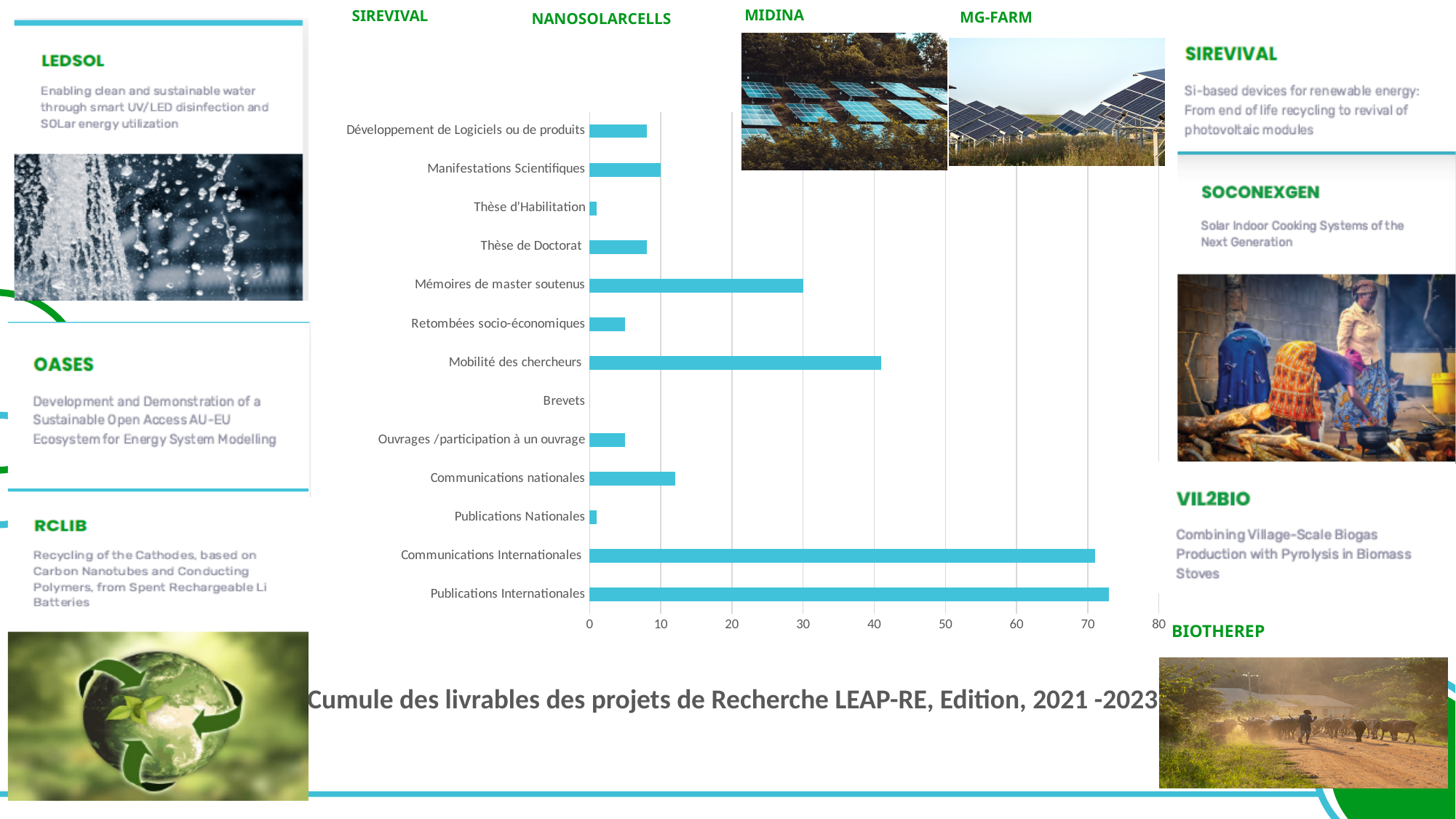
How many categories are listed on the chart's vertical axis? 13 Which is larger, the value for Communications nationales or the value for Publications Nationales? Communications nationales Which category has the lowest value on the chart? Brevets Is the value for Thèse de Doctorat greater or less than 10? less Which is larger, the value for Mobilité des chercheurs or the value for Mémoires de master soutenus? Mobilité des chercheurs What is the highest value shown on the chart's horizontal axis? 80 Is the value for Communications nationales greater or less than 10? greater Is the value for Publications Internationales greater or less than 70? greater What kind of chart is shown on the slide? bar chart What is the title printed below the chart? Cumule des livrables des projets de Recherche LEAP-RE, Edition, 2021 -2023